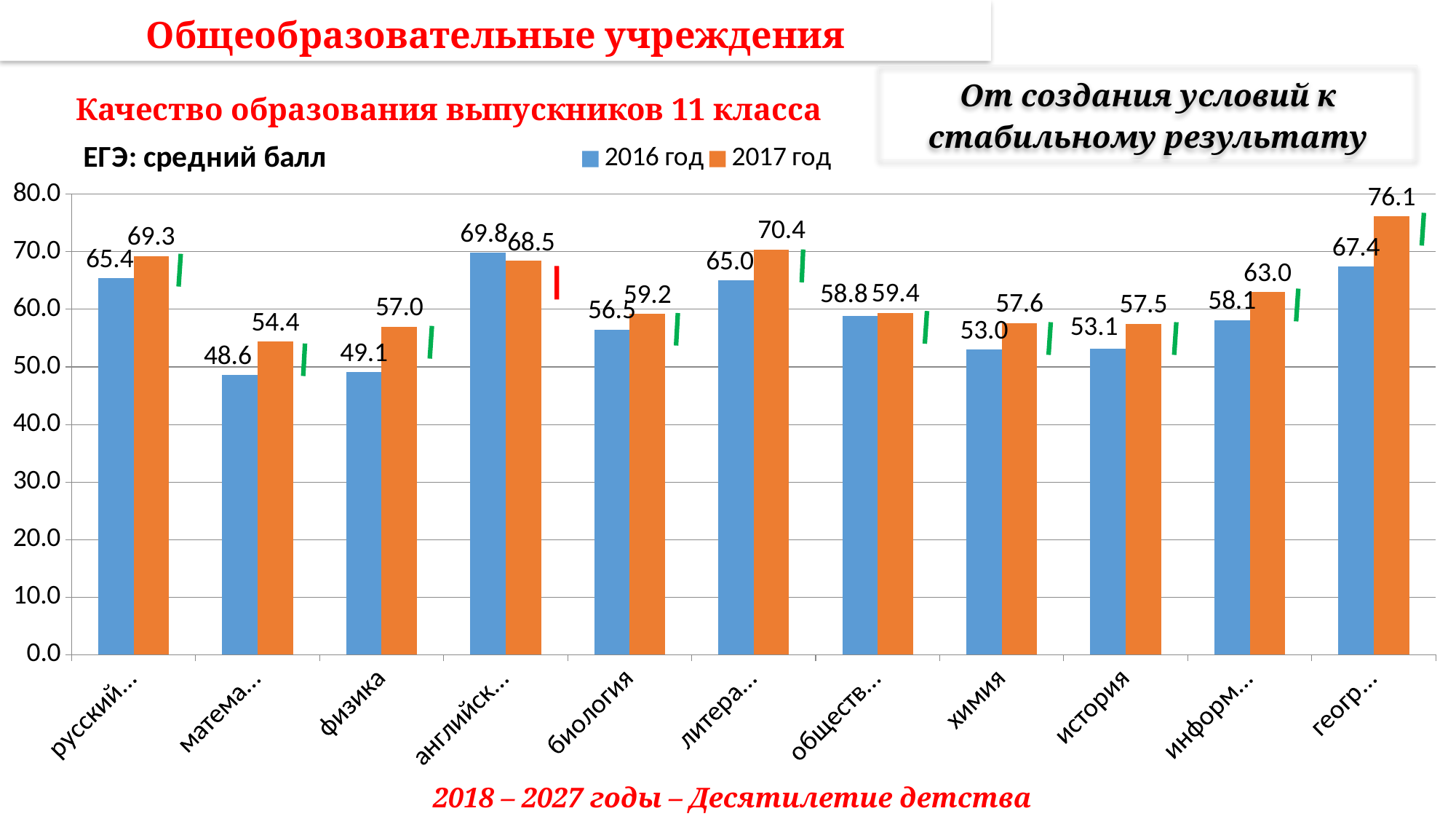
What are the two legend entries of the chart? 2016 год, 2017 год What is the lowest value in the 2016 год series? 48.6 What is the highest value in the 2017 год series? 76.1 What is the difference between the 2017 год and 2016 год values for биология? 2.7 What kind of chart is shown on the slide? bar chart How many categories are shown on the x axis? 11 What is the value for биология in the 2016 год series? 56.5 What is the difference between the 2017 год and 2016 год values for история? 4.4 For история, which series has the larger value, 2016 год or 2017 год? 2017 год How many series does the legend list? 2 What is the value for физика in the 2016 год series? 49.1 What is the value for химия in the 2017 год series? 57.6